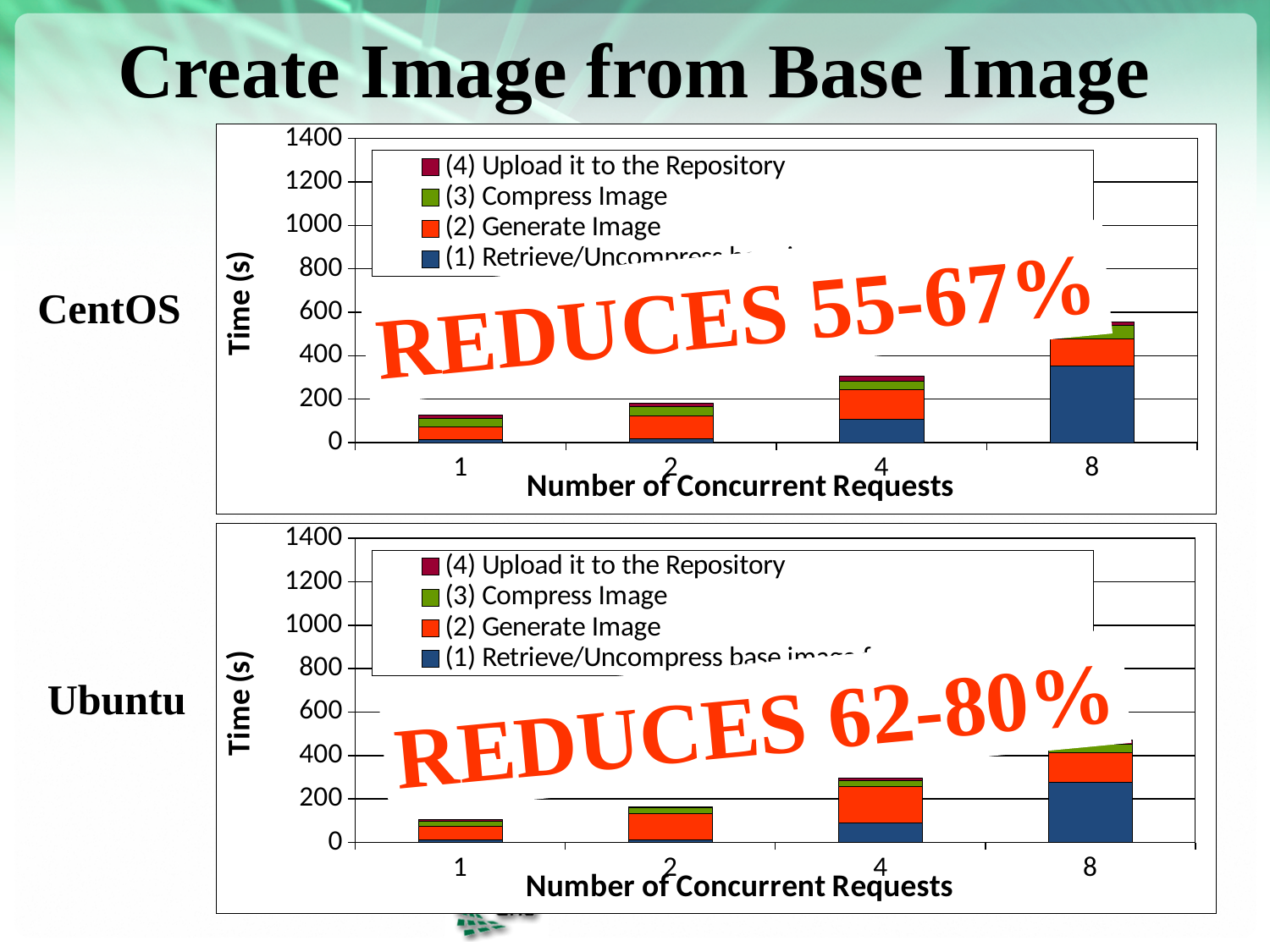
In the Ubuntu chart, how many series does the legend list? 4 In the Ubuntu chart, is the total time for 4 concurrent requests greater or less than 400? less What kind of chart is the top (CentOS) chart? stacked bar chart In the Ubuntu chart, which number of concurrent requests has the lowest total time? 1 In the CentOS chart, which number of concurrent requests has the highest total time? 8 In the Ubuntu chart, does the total time rise or fall as the number of concurrent requests increases? rise In the Ubuntu chart, is the total time for 8 concurrent requests greater or less than 200? greater In the CentOS chart, is the total time for 8 concurrent requests greater or less than 400? greater In the CentOS chart, which has the larger total time: 2 concurrent requests or 4 concurrent requests? 4 In the CentOS chart, how many categories are shown on the x axis? 4 What is the y-axis title of the Ubuntu chart? Time (s)